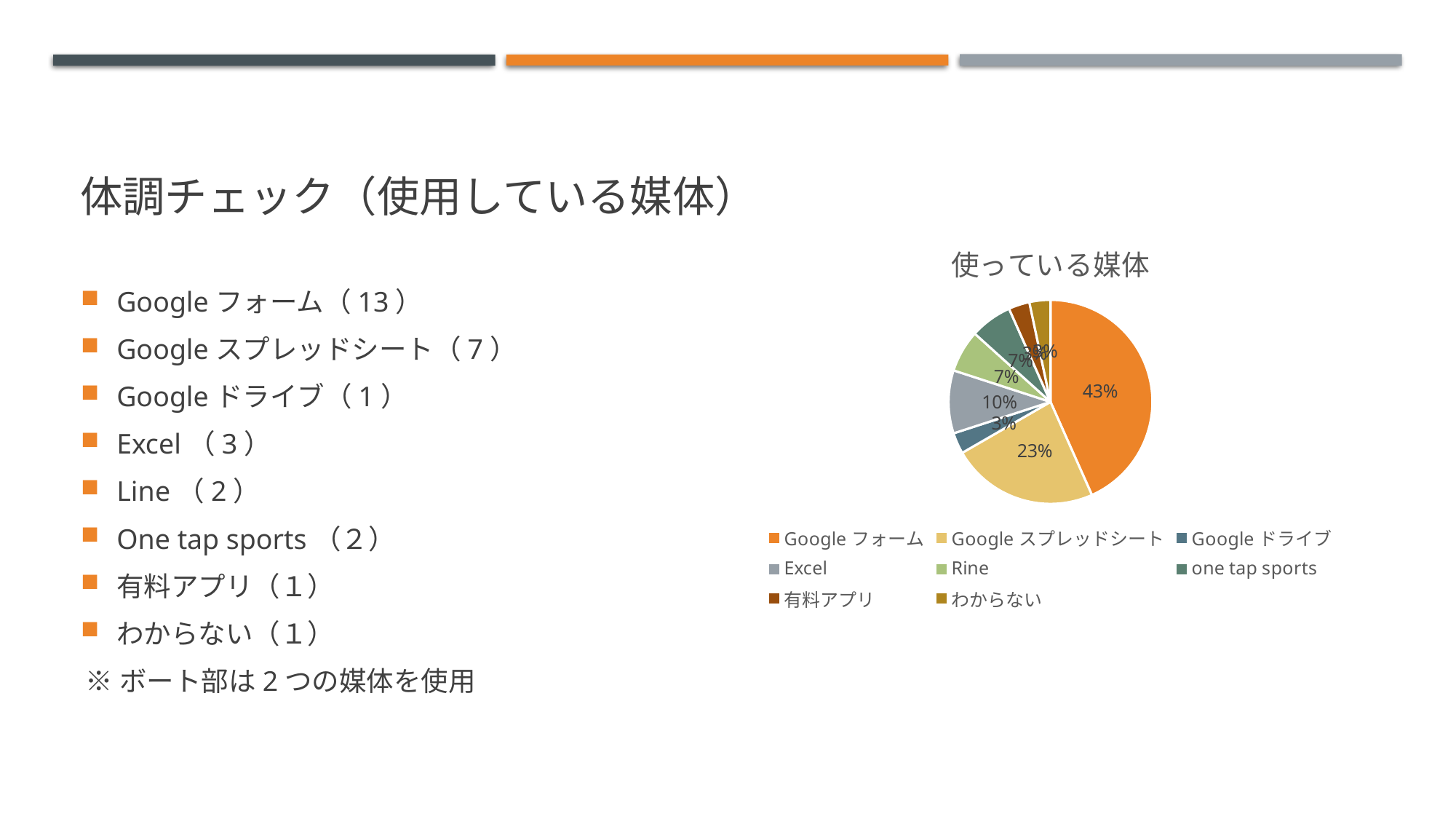
Which category has the largest share of the pie? Google フォーム How many entries does the chart's legend list? 8 What is the title of the chart? 使っている媒体 What kind of chart is shown on the slide? pie chart Which has a larger share, Google スプレッドシート or Excel? Google スプレッドシート What share of the pie does Google フォーム have? 43% What is the difference in percentage points between the Google フォーム share and the Google スプレッドシート share? 20 What colour is the Google フォーム slice in the pie chart? orange What share of the pie does Excel have? 10% What share of the pie does Google スプレッドシート have? 23% How many slices does the pie chart have? 8